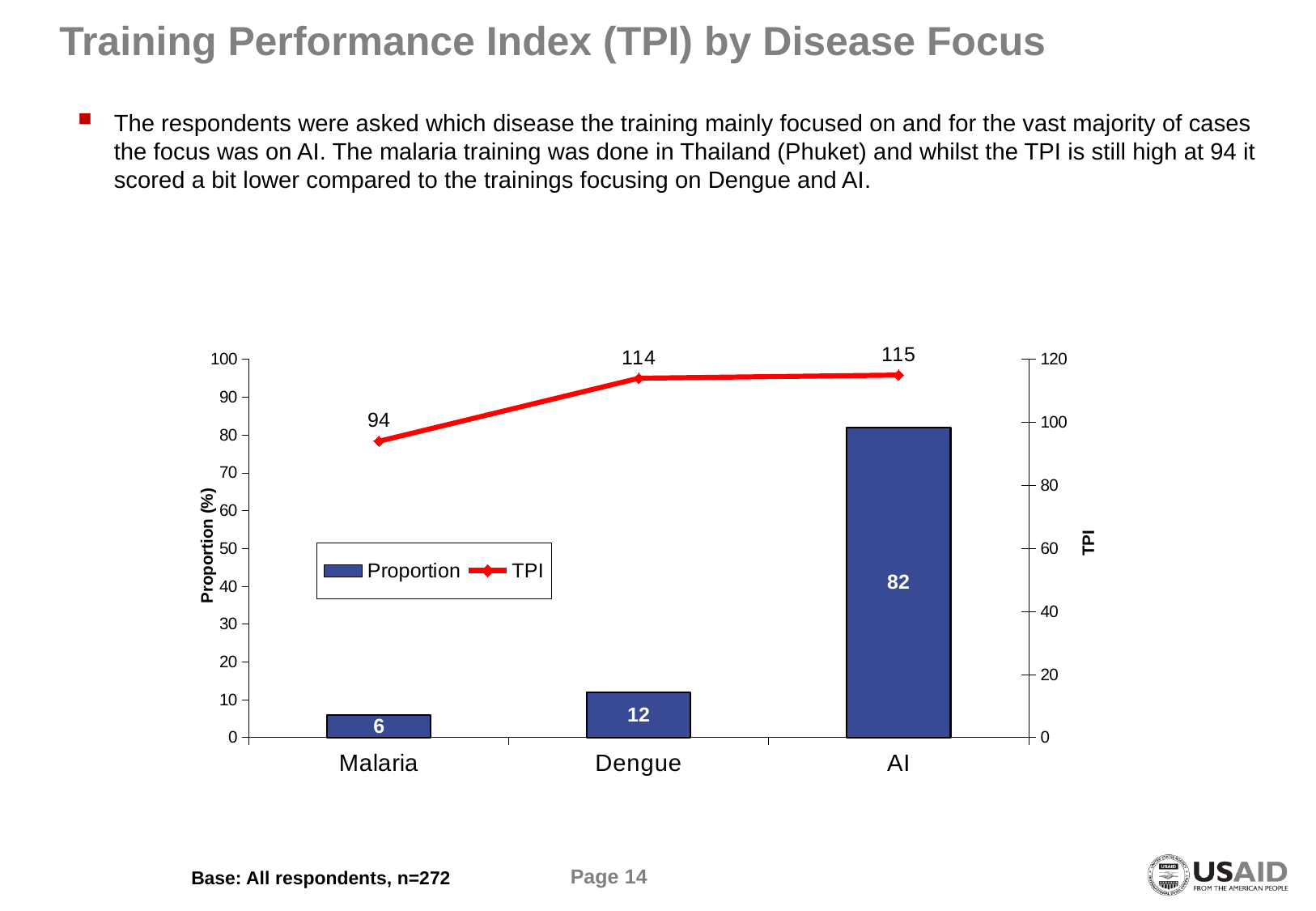
What is the difference in Proportion (%) between Dengue and Malaria? 6 What is the difference in TPI between AI and Malaria? 21 Which disease focus has the lowest TPI? Malaria Does the TPI line rise or fall from Malaria to AI? rise How many series does the legend list? 2 How many disease focus categories are shown on the x axis? 3 Which disease focus has the highest Proportion (%)? AI What is the Proportion (%) value for Malaria? 6 Which has a higher Proportion (%), Dengue or Malaria? Dengue What is the TPI value for Malaria? 94 What is the Proportion (%) value for AI? 82 What is the TPI value for Dengue? 114